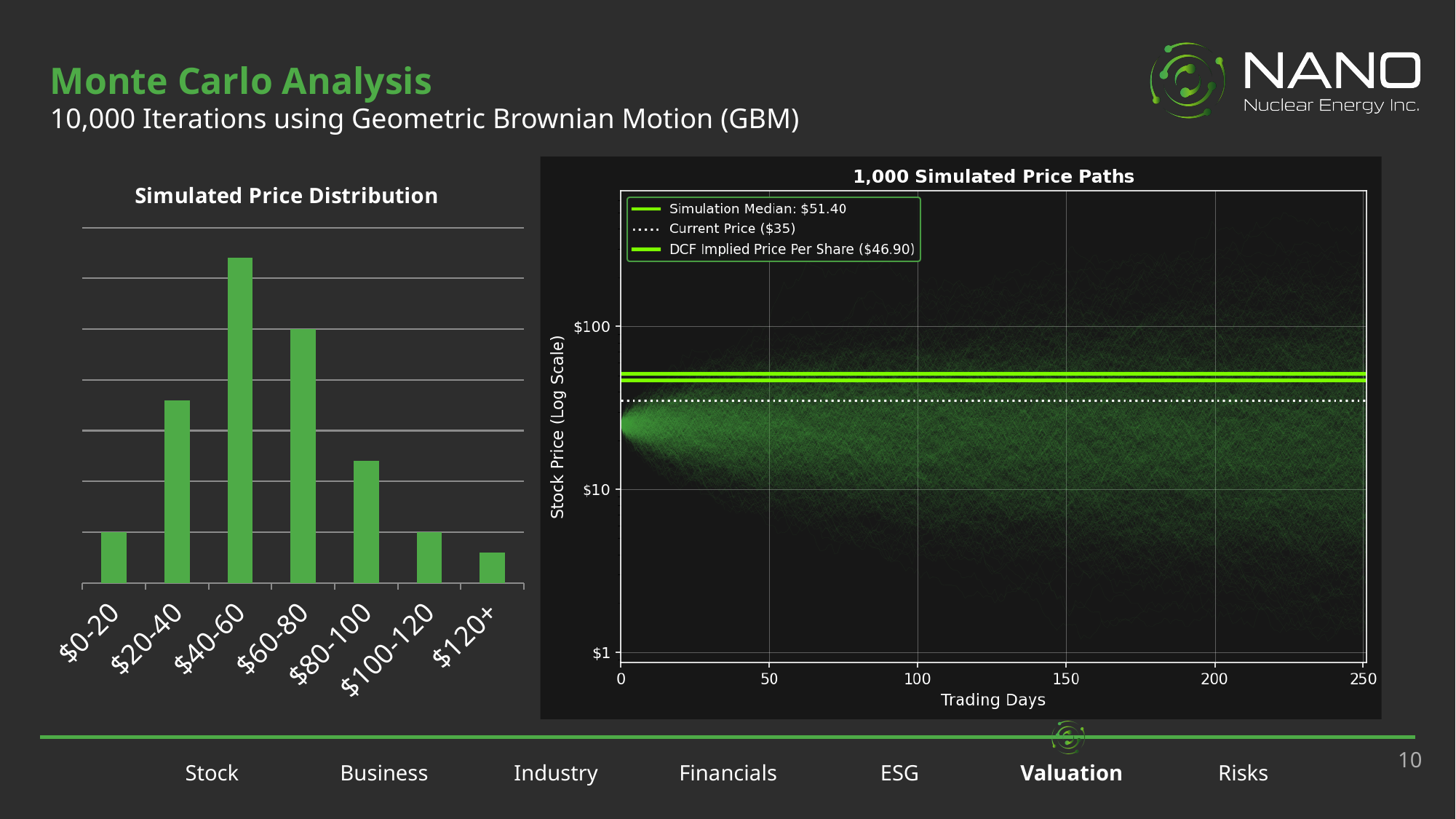
In the 1,000 Simulated Price Paths chart, how much higher is the Simulation Median than the DCF Implied Price Per Share? $4.50 How many price ranges are shown on the x axis of the Simulated Price Distribution chart? 7 In the 1,000 Simulated Price Paths chart, what is the Current Price shown in the legend? $35 In the 1,000 Simulated Price Paths chart, what is the DCF Implied Price Per Share shown in the legend? $46.90 In the Simulated Price Distribution chart, which price range has the shortest bar? $120+ In the Simulated Price Distribution chart, which price range has the tallest bar? $40-60 In the Simulated Price Distribution chart, which bar is taller: $20-40 or $60-80? $60-80 In the 1,000 Simulated Price Paths chart, what is the Simulation Median value shown in the legend? $51.40 How many entries does the legend of the 1,000 Simulated Price Paths chart list? 3 What kind of chart is the Simulated Price Distribution chart on the left? bar chart What is the x-axis label of the 1,000 Simulated Price Paths chart? Trading Days In the Simulated Price Distribution chart, which bar is taller: $80-100 or $20-40? $20-40